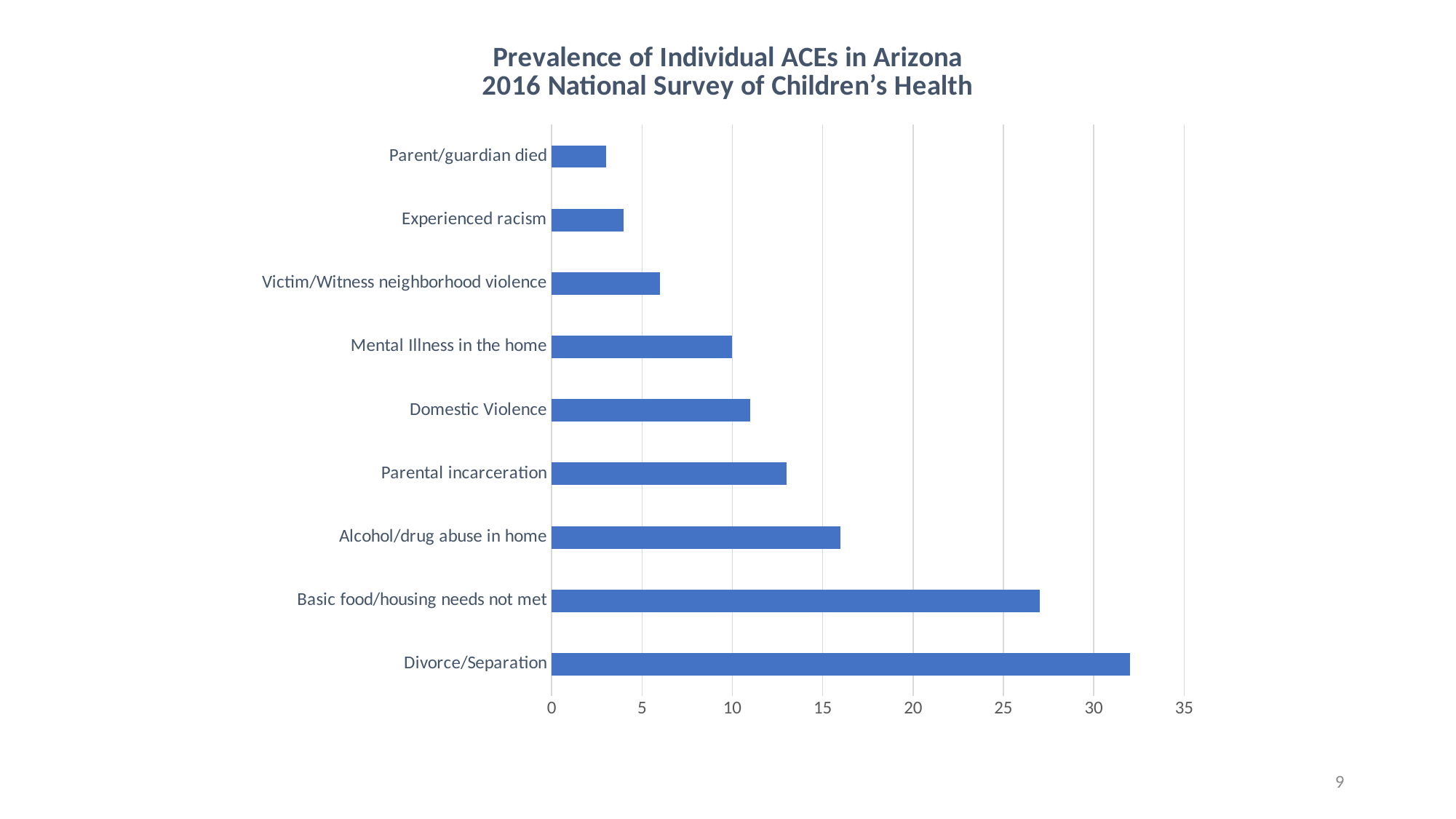
Which category has the lowest value? Parent/guardian died Is the value for Alcohol/drug abuse in home greater or less than 20? less Is the value for Experienced racism greater or less than 5? less Which category has the highest value? Divorce/Separation What is the value for Mental Illness in the home? 10 Which is larger, the value for Parental incarceration or the value for Domestic Violence? Parental incarceration What type of chart is shown on the slide? bar chart Which is larger, the value for Victim/Witness neighborhood violence or the value for Alcohol/drug abuse in home? Alcohol/drug abuse in home Is the value for Divorce/Separation greater or less than 30? greater How many categories (ACEs) are plotted in the chart? 9 What is the title of the chart? Prevalence of Individual ACEs in Arizona 2016 National Survey of Children's Health